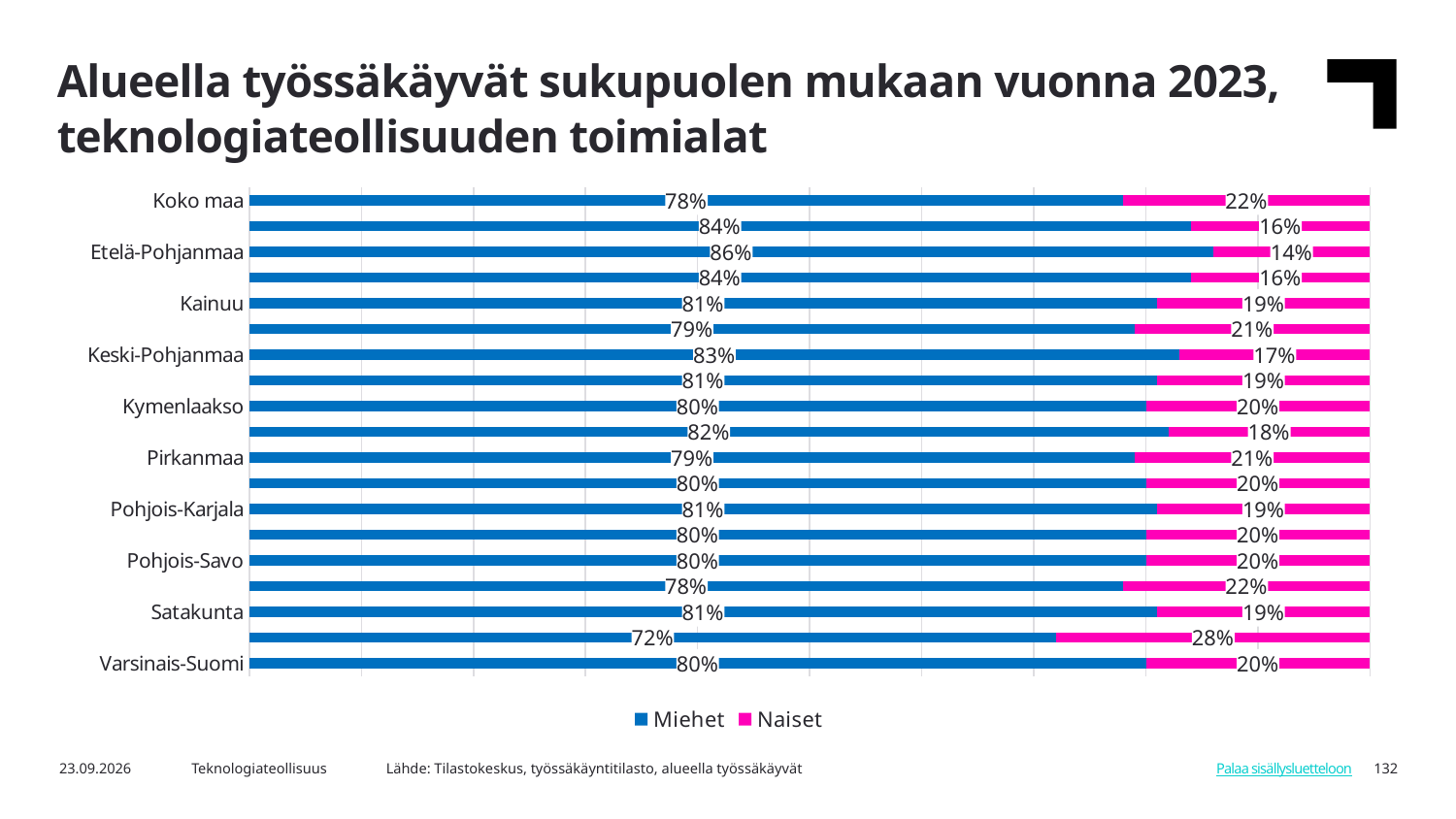
Which colour represents Naiset in the chart? Pink (magenta) What is the Naiset share for Etelä-Pohjanmaa? 14% Which region has the highest Miehet share? Etelä-Pohjanmaa Which has a larger Naiset share, Koko maa or Kainuu? Koko maa What is the Miehet share for Keski-Pohjanmaa? 83% What kind of chart is shown on the slide? Stacked bar chart Which region has the lowest Naiset share? Etelä-Pohjanmaa What is the Naiset share for Pirkanmaa? 21% What is the Miehet share for Koko maa? 78% What is the difference between the Miehet share of Etelä-Pohjanmaa and that of Koko maa? 8% What is the total of the Miehet and Naiset shares for Satakunta? 100% How many series does the legend list? 2